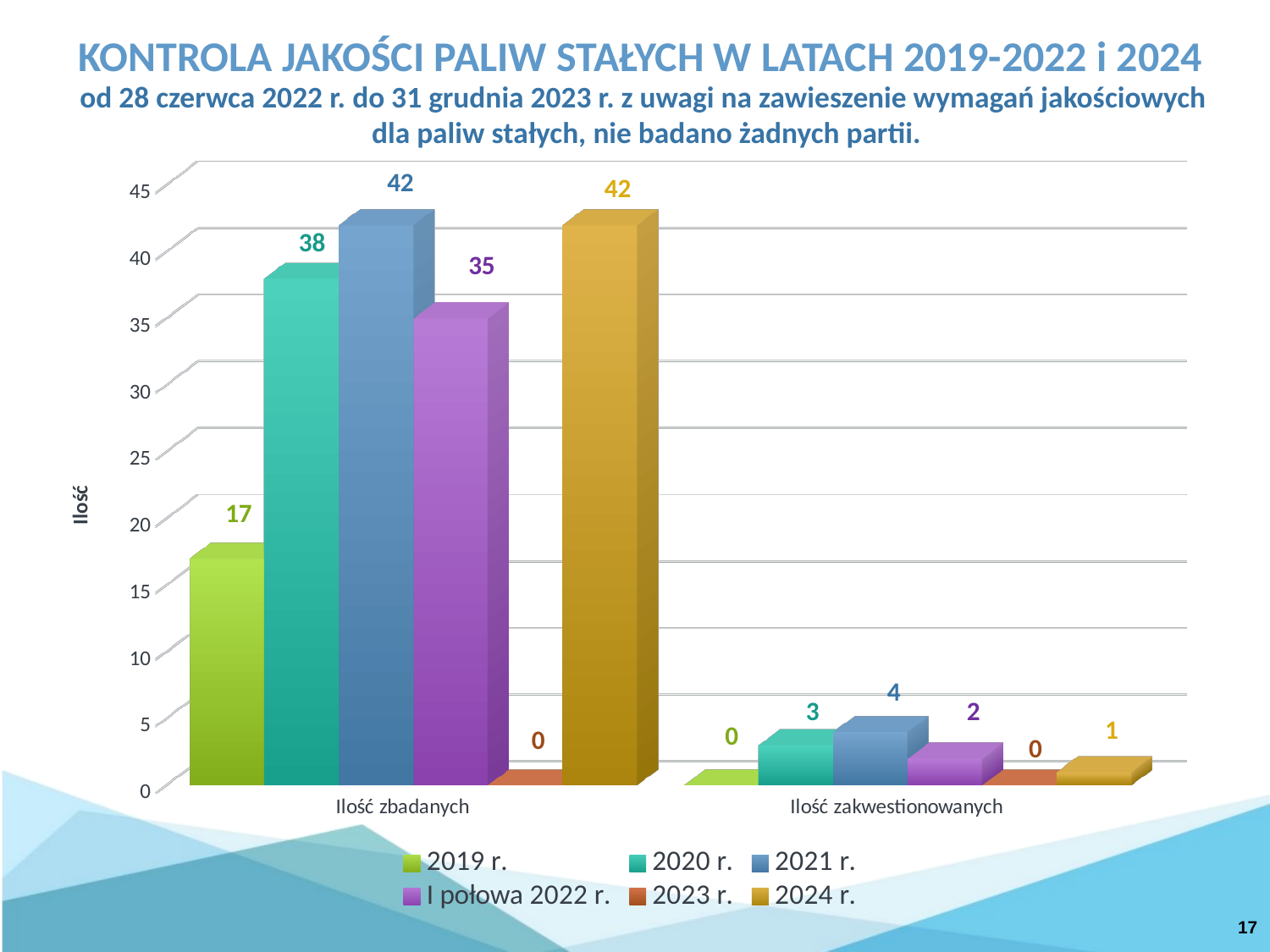
What is the label of the vertical axis? Ilość Which series has the highest value in the Ilość zakwestionowanych category? 2021 r. What is the value for 2019 r. in the Ilość zbadanych category? 17 What is the value for I połowa 2022 r. in the Ilość zbadanych category? 35 How many series does the legend list? 6 What is the value for 2024 r. in the Ilość zakwestionowanych category? 1 How many categories are shown on the x axis? 2 Which series has the lowest value in the Ilość zbadanych category? 2023 r. What is the value for 2021 r. in the Ilość zakwestionowanych category? 4 What kind of chart is shown on the slide? Bar chart Which is larger in the Ilość zbadanych category: the value for 2020 r. or the value for I połowa 2022 r.? 2020 r. What is the difference between the 2020 r. and 2019 r. values in the Ilość zbadanych category? 21